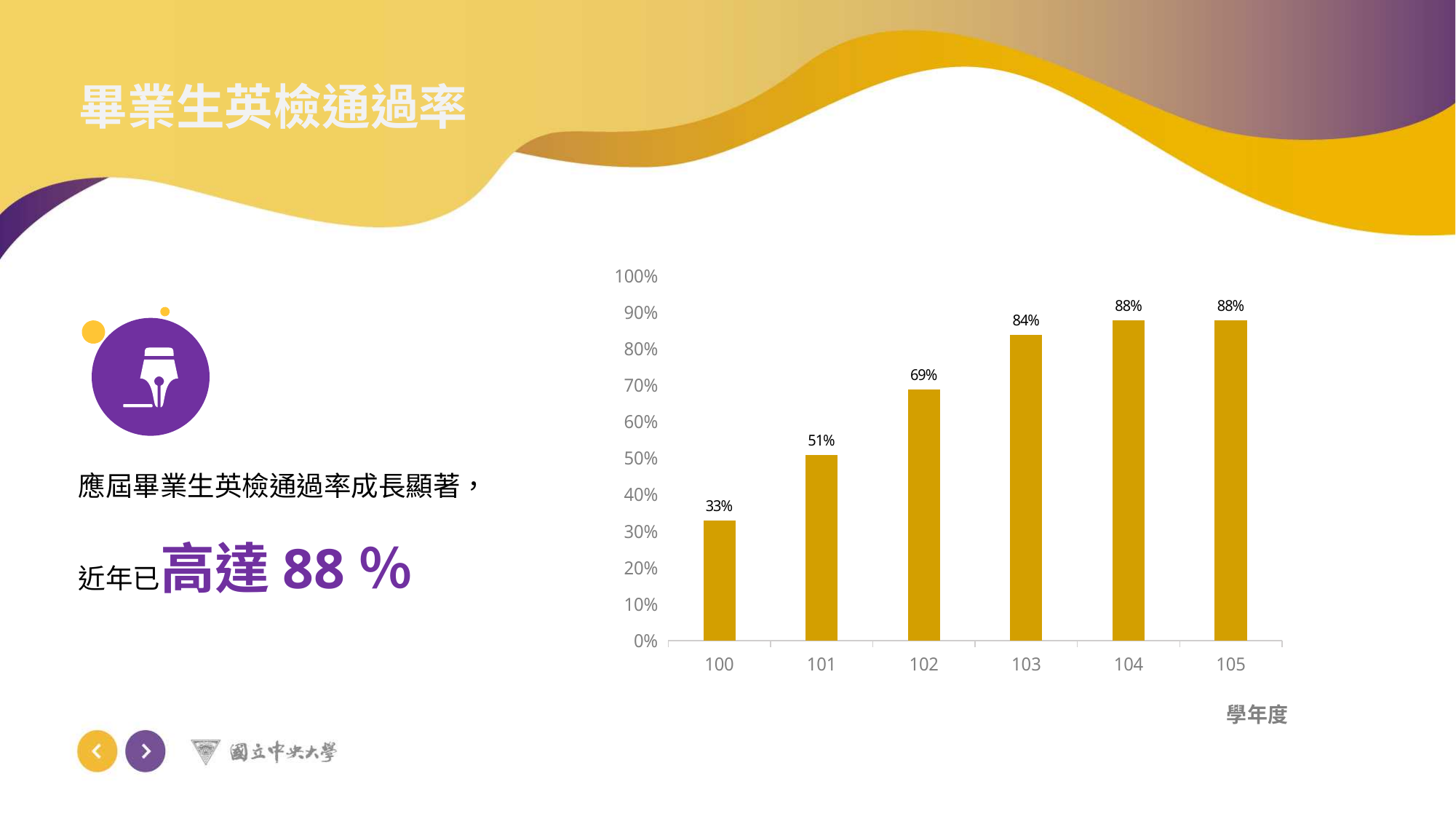
What is the label shown below the x axis of the chart? 學年度 What is the pass rate for academic year 100? 33% What is the pass rate for academic year 102? 69% What is the difference between the pass rates for academic years 104 and 103? 4% Which academic year has the lowest pass rate? 100 What is the difference between the pass rates for academic years 101 and 100? 18% Do the pass rates rise or fall from academic year 100 to 105? rise Is the pass rate for academic year 103 greater or less than 80%? greater What is the pass rate for academic year 103? 84% What kind of chart is shown on the slide? bar chart Which is larger, the pass rate for academic year 102 or for academic year 101? 102 How many academic years are shown on the x axis? 6